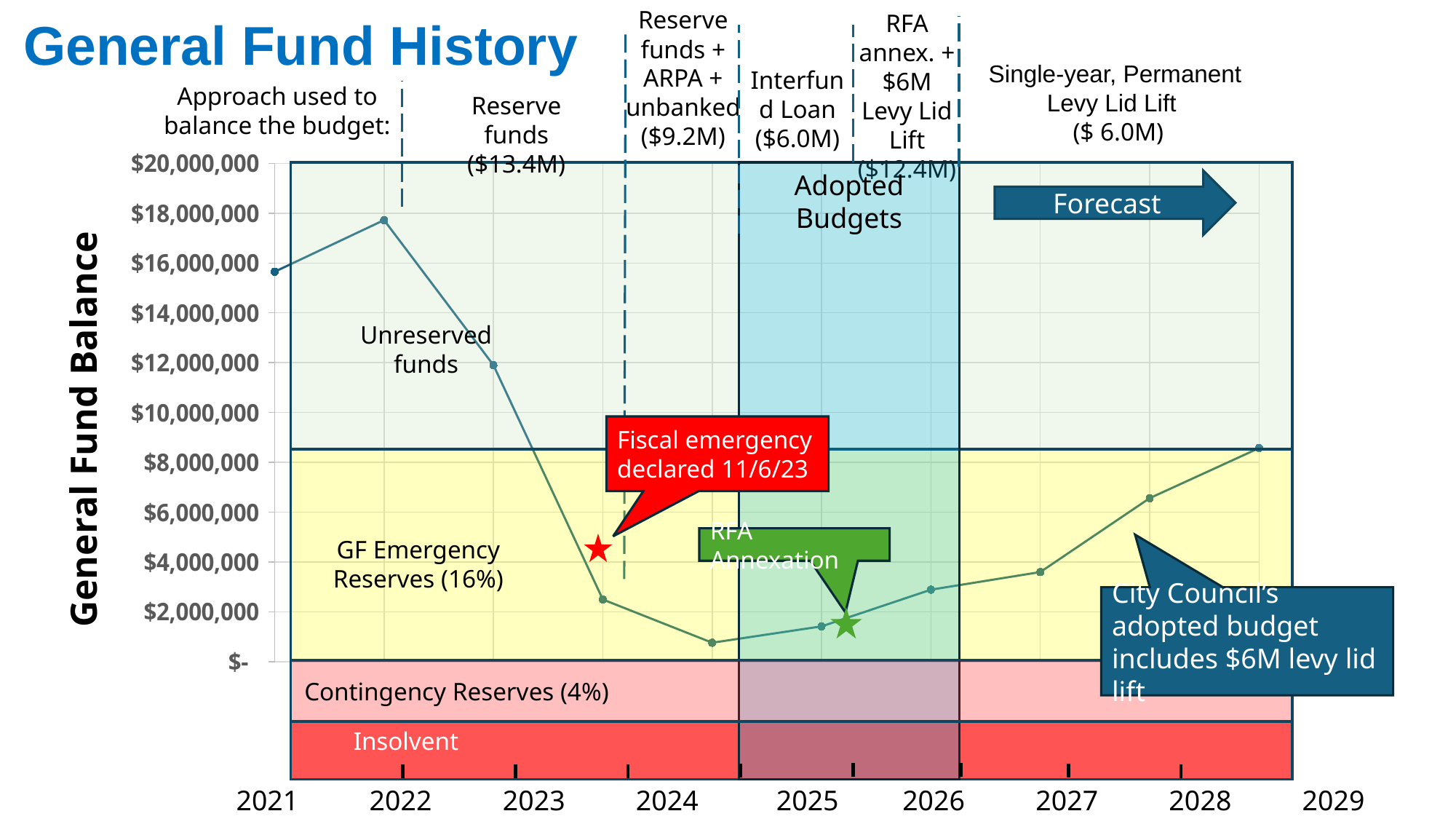
Is the General Fund Balance at 2023 greater or less than $10,000,000? greater What kind of chart is shown on the slide? line chart Is the General Fund Balance at 2022 greater or less than $16,000,000? greater In which year does the General Fund Balance line reach its highest point? 2022 What is the label on the vertical axis of the chart? General Fund Balance Does the General Fund Balance rise or fall between 2022 and 2024? fall Is the General Fund Balance at 2024 greater or less than $4,000,000? less Which year has the larger General Fund Balance, 2024 or 2027? 2027 Which year has the larger General Fund Balance, 2022 or 2023? 2022 Does the General Fund Balance rise or fall between 2025 and 2029? rise What is the title of the chart? General Fund History